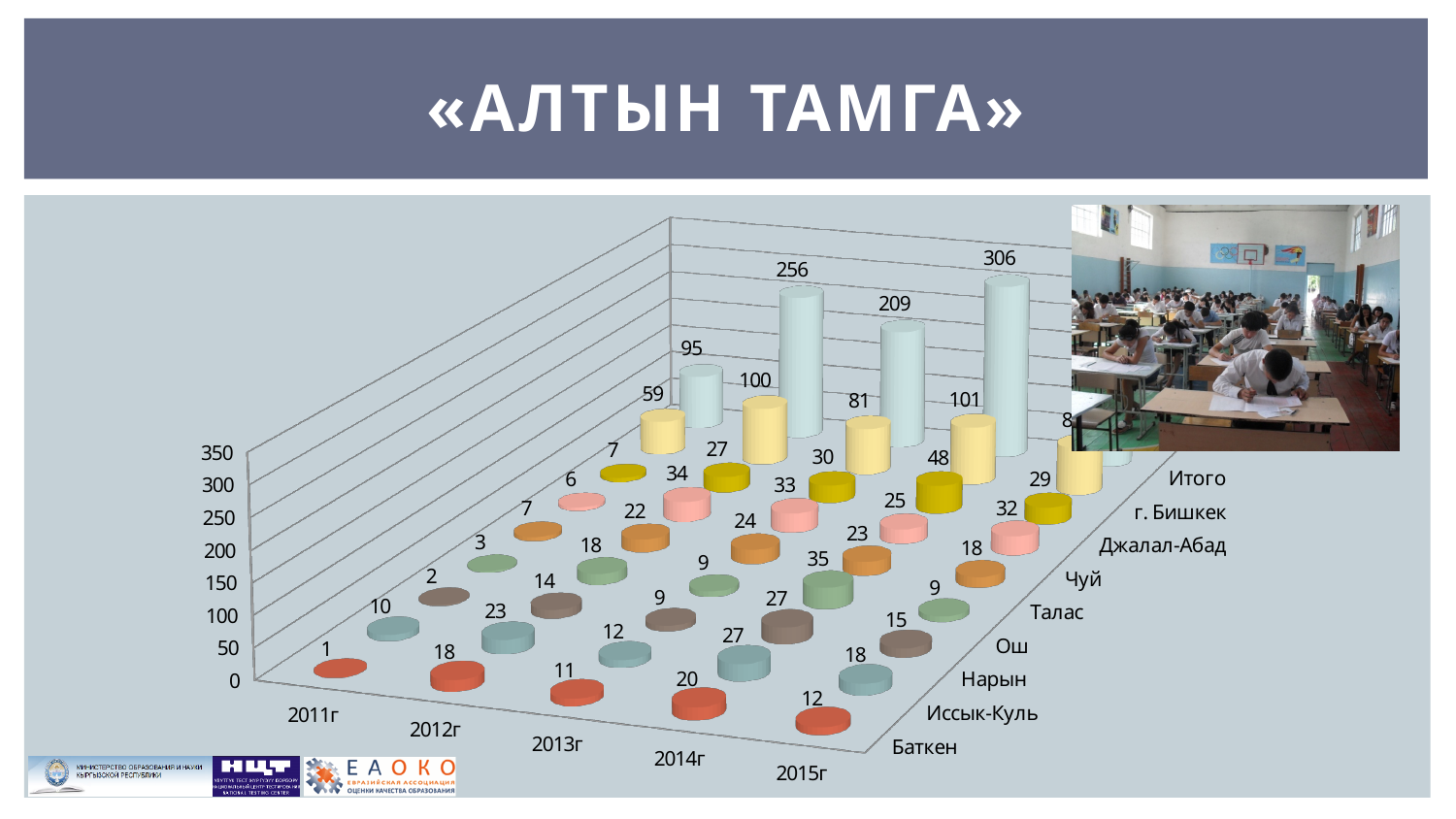
What is the value for Баткен in 2011? 1 Which is larger: the value for Ош in 2014 or the value for Талас in 2014? Ош in 2014 Which year has the lowest value for Иссык-Куль? 2011 What kind of chart is shown on the slide? bar chart How many years are shown on the x axis? 5 What is the difference between the Итого values for 2012 and 2013? 47 What is the value for Итого in 2014? 306 What is the value for Чуй in 2015? 32 What is the value for г. Бишкек in 2012? 100 Is the value for Итого in 2012 greater or less than 250? greater Which year has the highest value for Итого among the years with printed labels (2011–2014)? 2014 What is the value for Джалал-Абад in 2014? 48